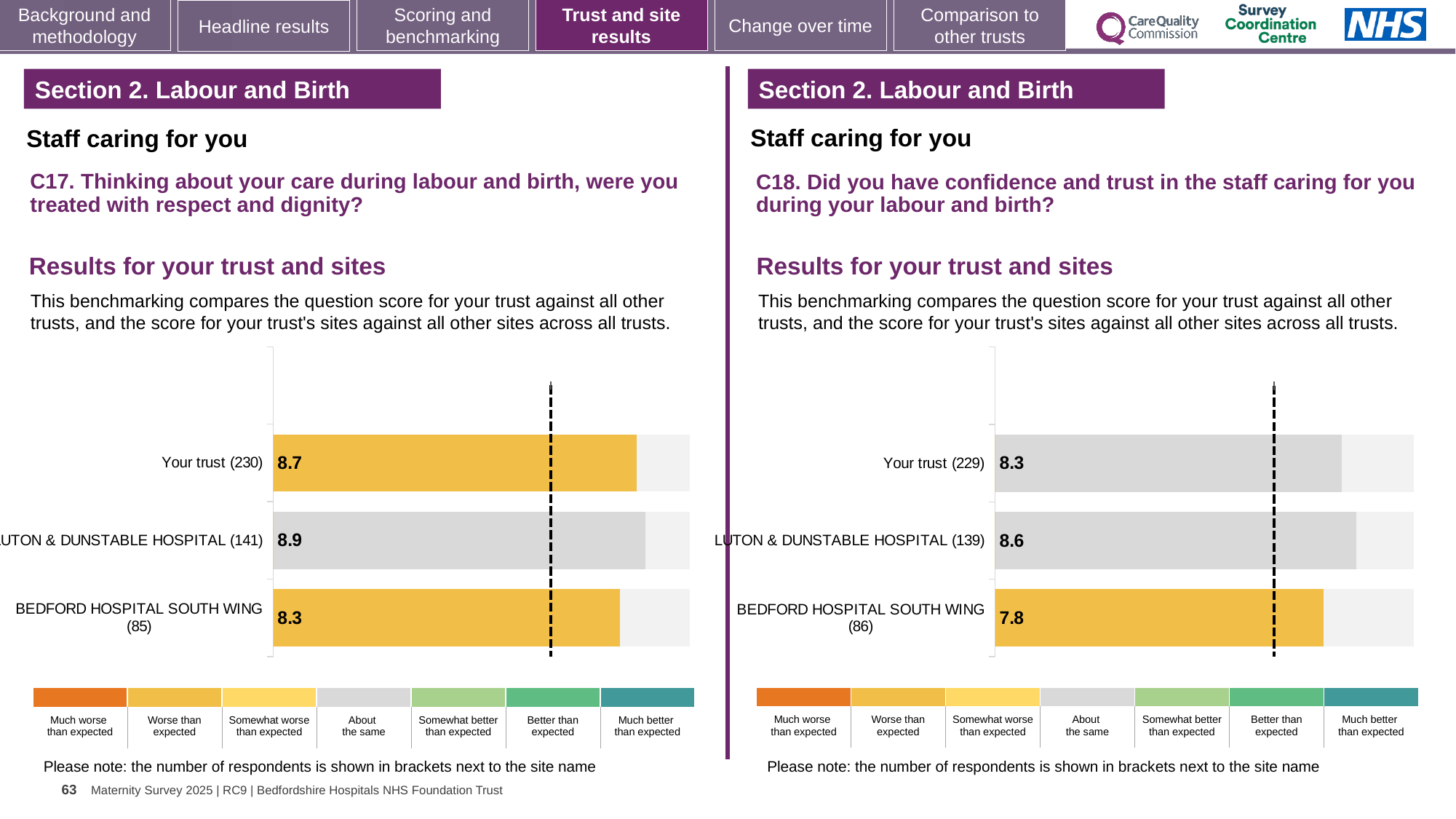
In the C17 chart on the left, what is the score for Bedford Hospital South Wing (85)? 8.3 In the C18 chart on the right, what is the score for Bedford Hospital South Wing (86)? 7.8 How many bars are shown in the C17 chart on the left? 3 In the C18 chart on the right, which benchmark category does the colour of the Bedford Hospital South Wing bar correspond to? Worse than expected In the C18 chart on the right, what is the difference between the scores for Your trust and Bedford Hospital South Wing? 0.5 What type of chart is used for the C18 results on the right? Bar chart In the C17 chart on the left, what is the difference between the scores for Luton & Dunstable Hospital and Bedford Hospital South Wing? 0.6 In the C18 chart on the right, which site or trust has the lowest score? Bedford Hospital South Wing (86) In the C17 chart on the left, what is the score for Your trust (230)? 8.7 In the C18 chart on the right, what is the score for Luton & Dunstable Hospital (139)? 8.6 In the C18 chart on the right, which has the larger score: Your trust (229) or Luton & Dunstable Hospital (139)? Luton & Dunstable Hospital (139) In the C17 chart on the left, which site or trust has the highest score? Luton & Dunstable Hospital (141)